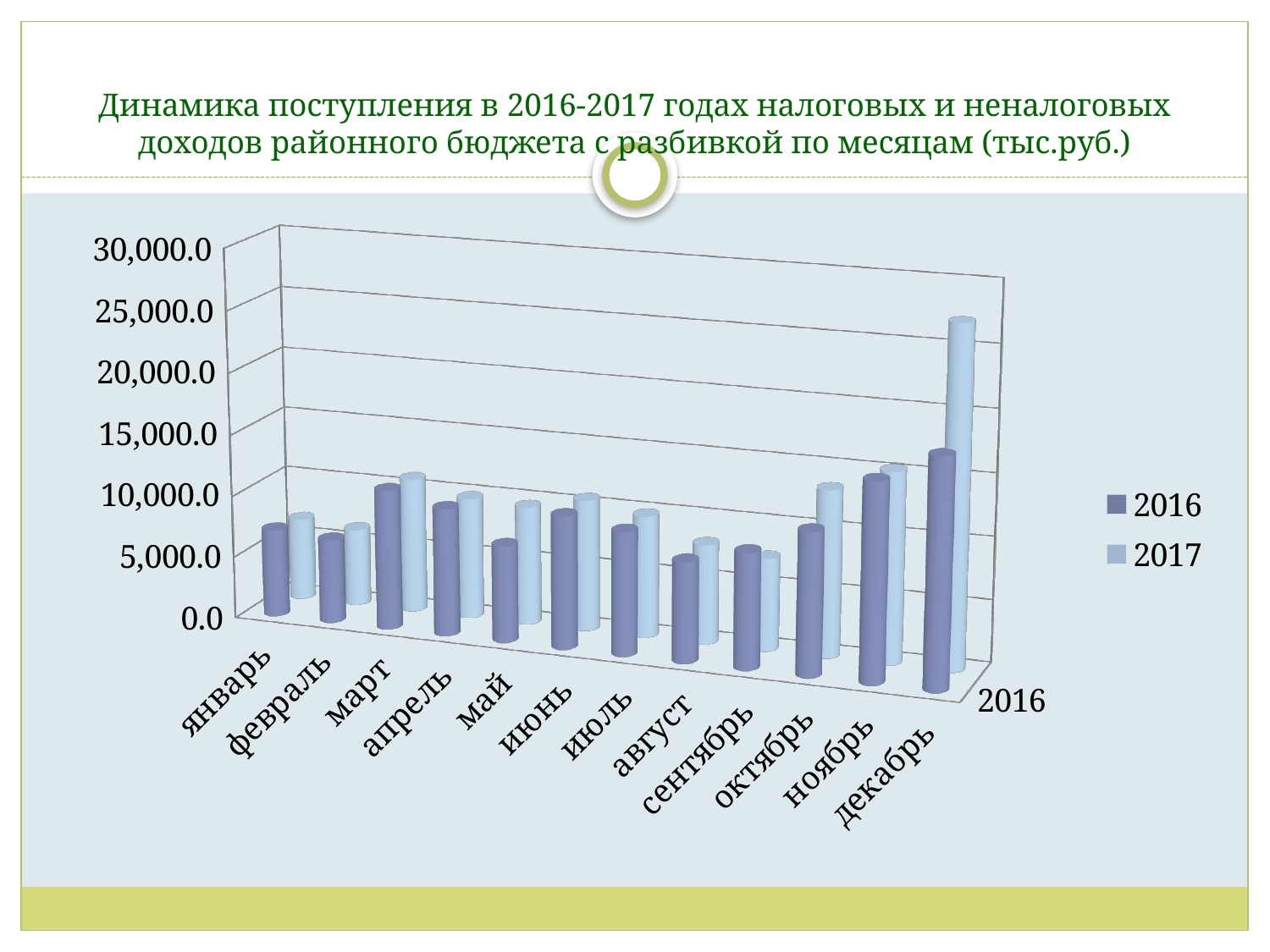
Which series are listed in the legend? 2016 and 2017 For декабрь, which series has the larger value, 2016 or 2017? 2017 Is the value for декабрь in the 2017 series greater or less than 20,000.0? greater For май, which series has the larger value, 2016 or 2017? 2017 What kind of chart is shown on the slide? bar chart Is the value for май in the 2016 series greater or less than 10,000.0? less How many series does the legend list? 2 Is the value for октябрь in the 2017 series greater or less than 5,000.0? greater How many months (categories) are shown on the x axis? 12 Which month has the highest value for the 2016 series? декабрь Which month has the highest value for the 2017 series? декабрь